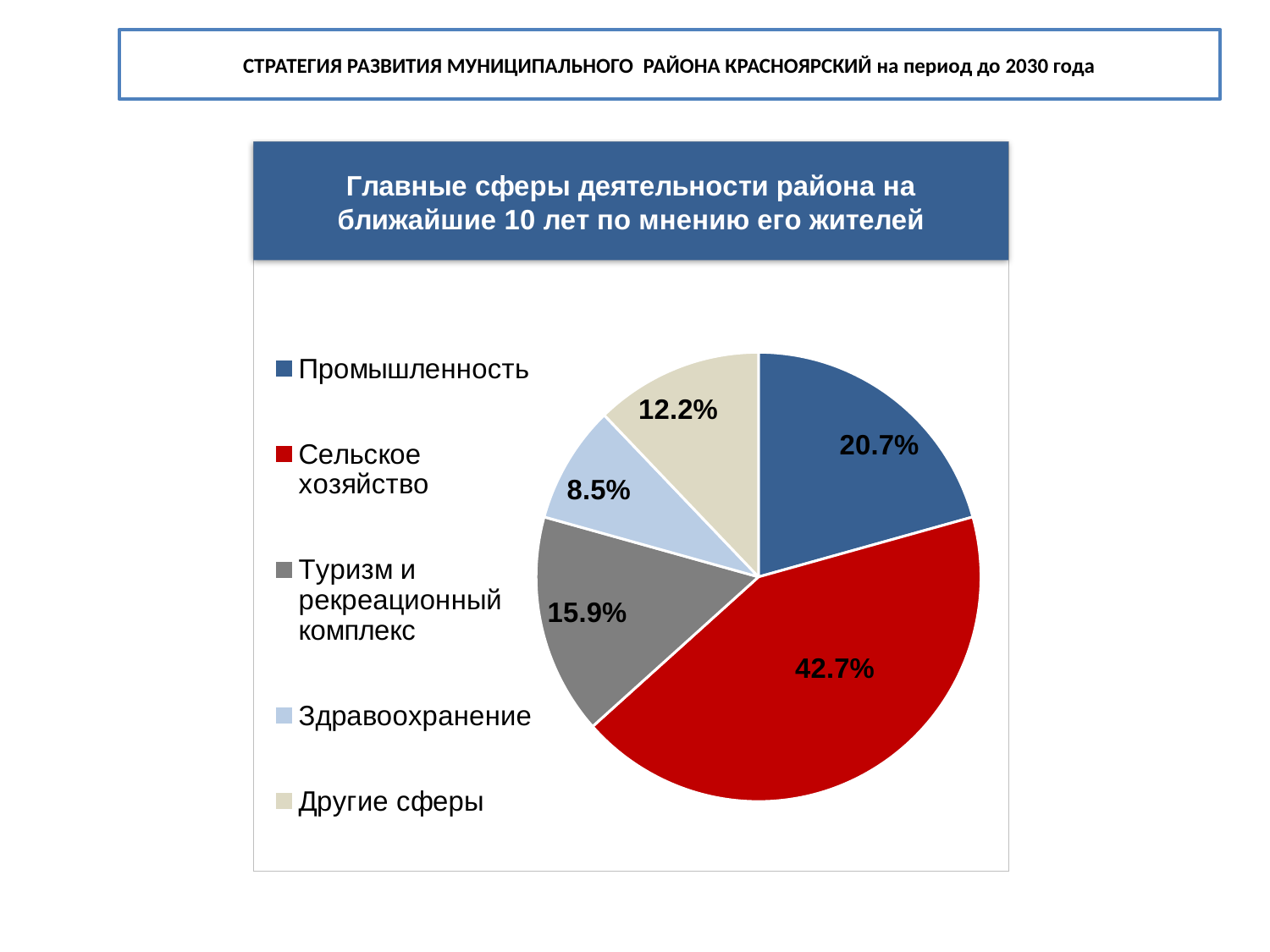
What share of the pie does Другие сферы have? 12.2% What kind of chart is shown on the slide? Pie chart Which category has the largest slice of the pie? Сельское хозяйство What share of the pie does Здравоохранение have? 8.5% Which is larger, the share of Туризм и рекреационный комплекс or the share of Другие сферы? Туризм и рекреационный комплекс What share of the pie does Туризм и рекреационный комплекс have? 15.9% How many categories does the pie chart show? 5 What is the difference between the shares of Сельское хозяйство and Промышленность? 22.0 percentage points Which category has the smallest slice of the pie? Здравоохранение What share of the pie does Сельское хозяйство have? 42.7% What share of the pie does Промышленность have? 20.7% What is the title of the chart? Главные сферы деятельности района на ближайшие 10 лет по мнению его жителей